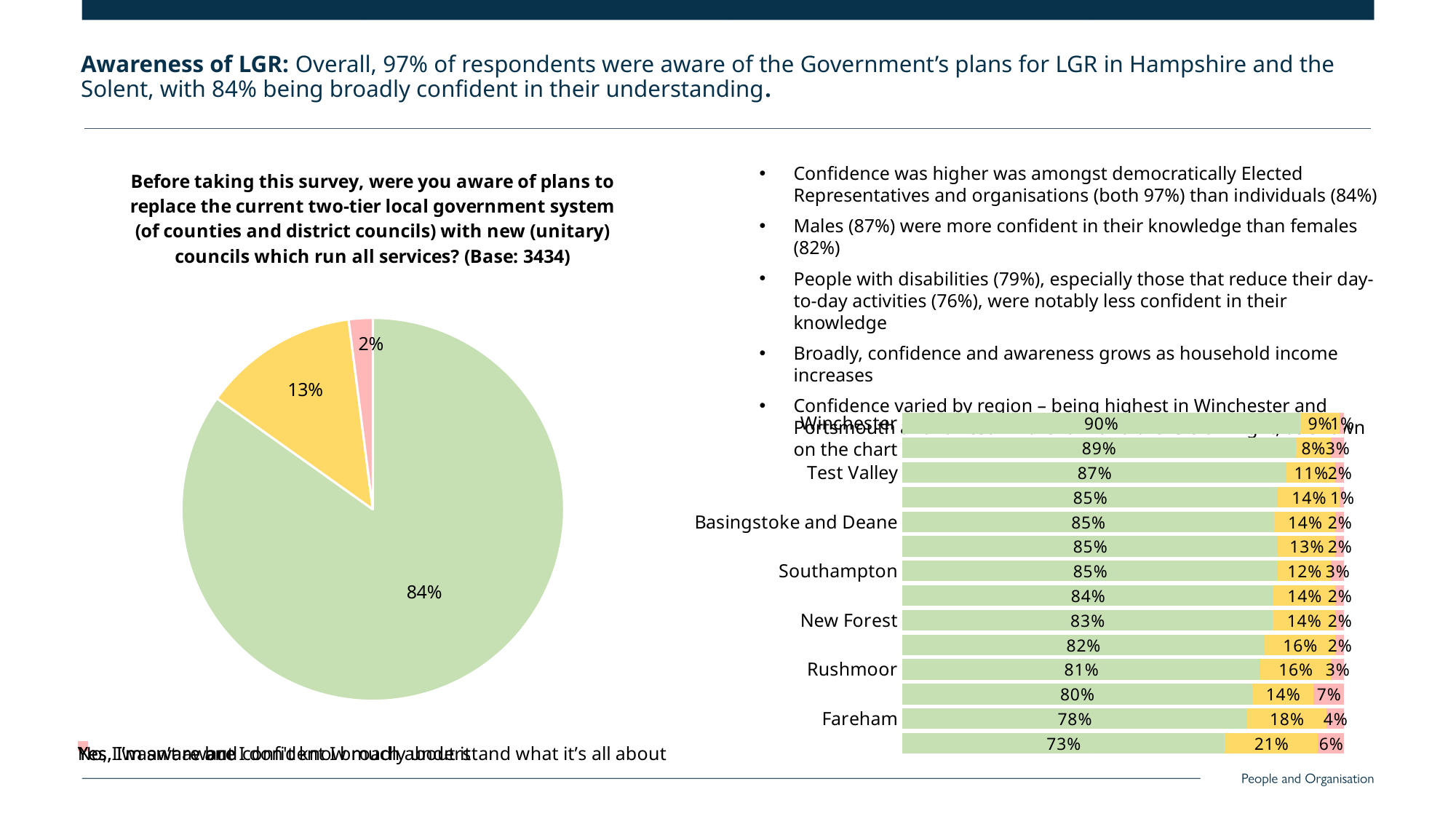
How many slices does the pie chart on the left have? 3 In the bar chart on the right, what is the value of the green segment for Test Valley? 87% In the bar chart on the right, what is the value of the green segment for Fareham? 78% In the pie chart on the left, what is the difference between the largest slice (84%) and the yellow slice (13%)? 71 percentage points In the pie chart on the left, what is the value of the smallest slice? 2% In the bar chart on the right, what is the value of the green segment for Winchester? 90% In the bar chart on the right, which has the larger green segment, Winchester or Fareham? Winchester In the pie chart on the left, what is the value of the largest slice? 84% What kind of chart is the chart on the left of the slide? Pie chart In the bar chart on the right, what is the value of the yellow segment for Rushmoor? 16% How many bars are there in the bar chart on the right? 14 What kind of chart is the chart on the right of the slide? Bar chart